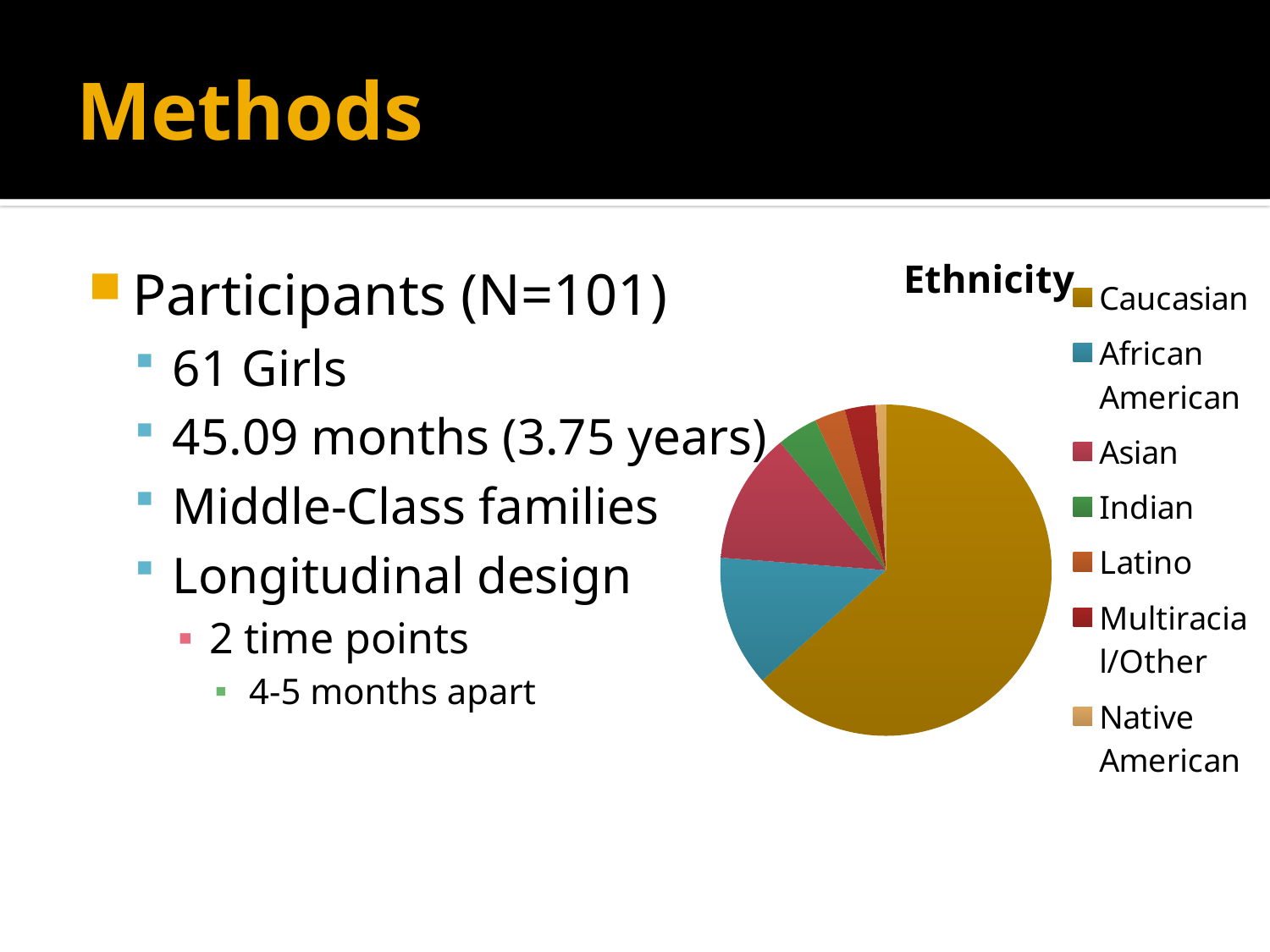
How many ethnicity categories does the pie chart show? 7 Which slice is larger, Caucasian or African American? Caucasian Which colour represents the Caucasian category in the pie chart? gold What kind of chart is shown on the slide? pie chart Which ethnicity category has the smallest slice of the pie? Native American What is the title of the chart? Ethnicity Which ethnicity category has the largest slice of the pie? Caucasian Which slice is larger, African American or Latino? African American Which slice is larger, Multiracial/Other or Native American? Multiracial/Other Does the Caucasian slice make up more or less than half of the pie? more